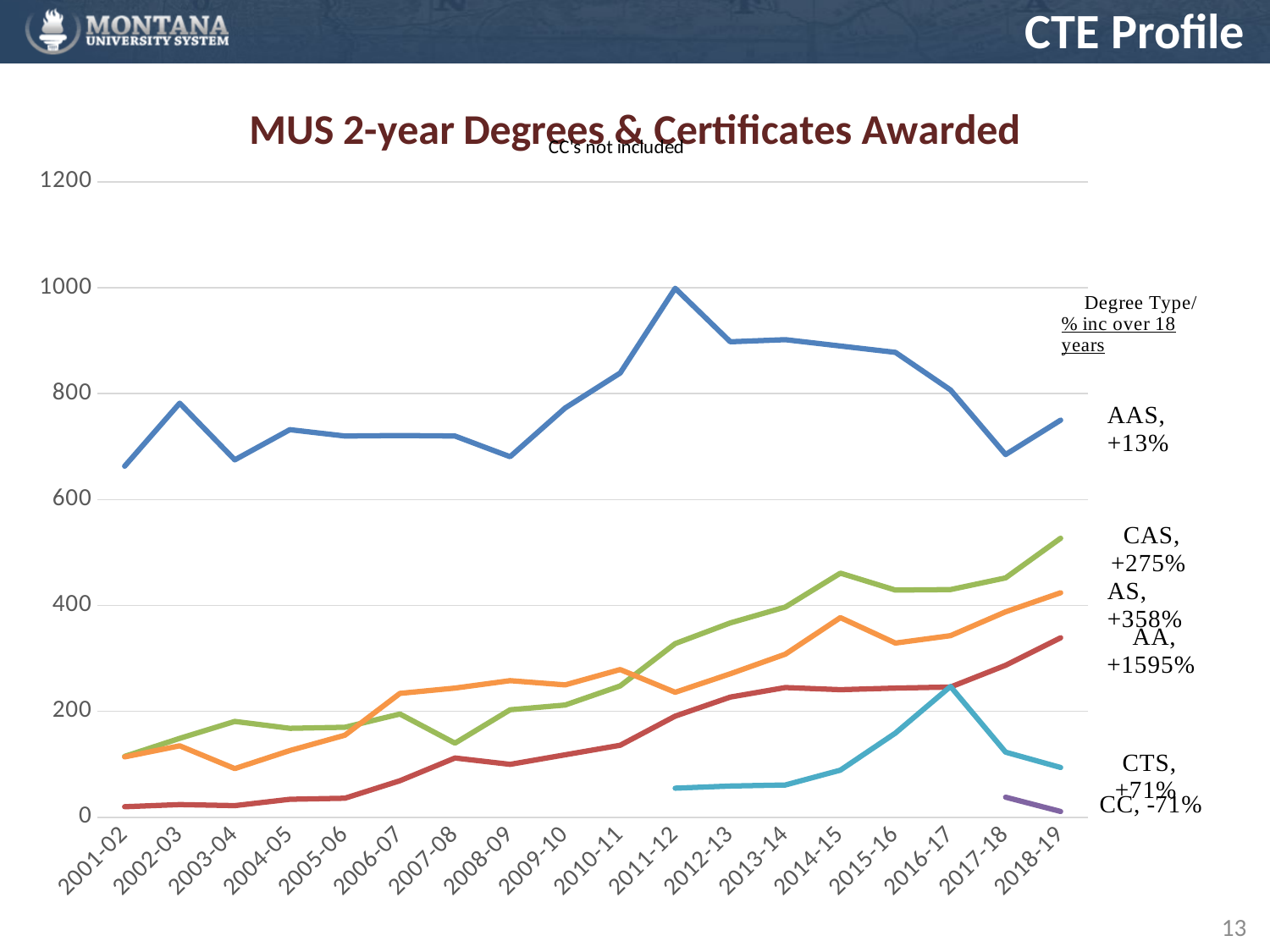
Is the value for CAS in 2018-19 greater or less than 400? greater Which degree type has the highest number of awards in 2018-19? AAS Which degree type has the lowest number of awards in 2018-19? CC What kind of chart is shown on the slide? line chart Does the AA series generally rise or fall from 2001-02 to 2018-19? rise Is the value for AA in 2001-02 greater or less than 200? less What percentage increase over 18 years is shown for the AA degree type? +1595% Is the value for AAS in 2011-12 greater or less than 800? greater How many degree-type series are labelled on the chart? 6 How many academic years are shown along the x axis of the chart? 18